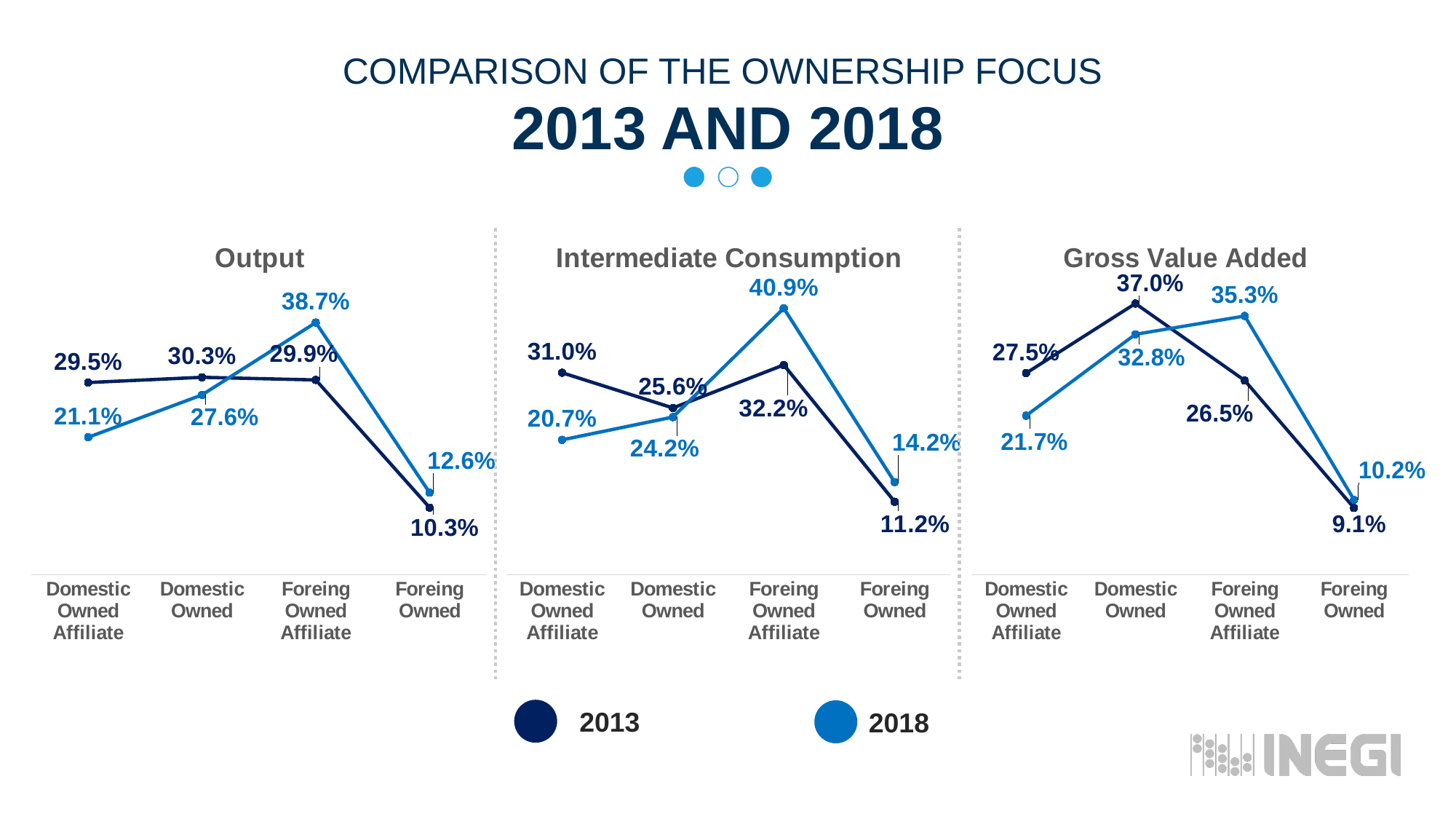
In the Output chart, what is the 2018 value for Foreign Owned Affiliate? 38.7% How many categories are shown on the x axis of the Output chart? 4 How many series does the legend list? 2 In the Output chart, what is the 2013 value for Domestic Owned? 30.3% What kind of chart is the Intermediate Consumption chart? Line chart In the Intermediate Consumption chart, which category has the lowest 2018 value? Foreign Owned In the Gross Value Added chart, what is the difference between the 2013 and 2018 values for Domestic Owned? 4.2 percentage points In the Gross Value Added chart, which category has the highest 2013 value? Domestic Owned In the Intermediate Consumption chart, which is larger for Domestic Owned Affiliate: the 2013 value or the 2018 value? 2013 In the Output chart, what is the difference between the 2018 and 2013 values for Foreign Owned Affiliate? 8.8 percentage points In the Gross Value Added chart, what is the 2013 value for Foreign Owned? 9.1% In the Intermediate Consumption chart, what is the 2018 value for Domestic Owned Affiliate? 20.7%